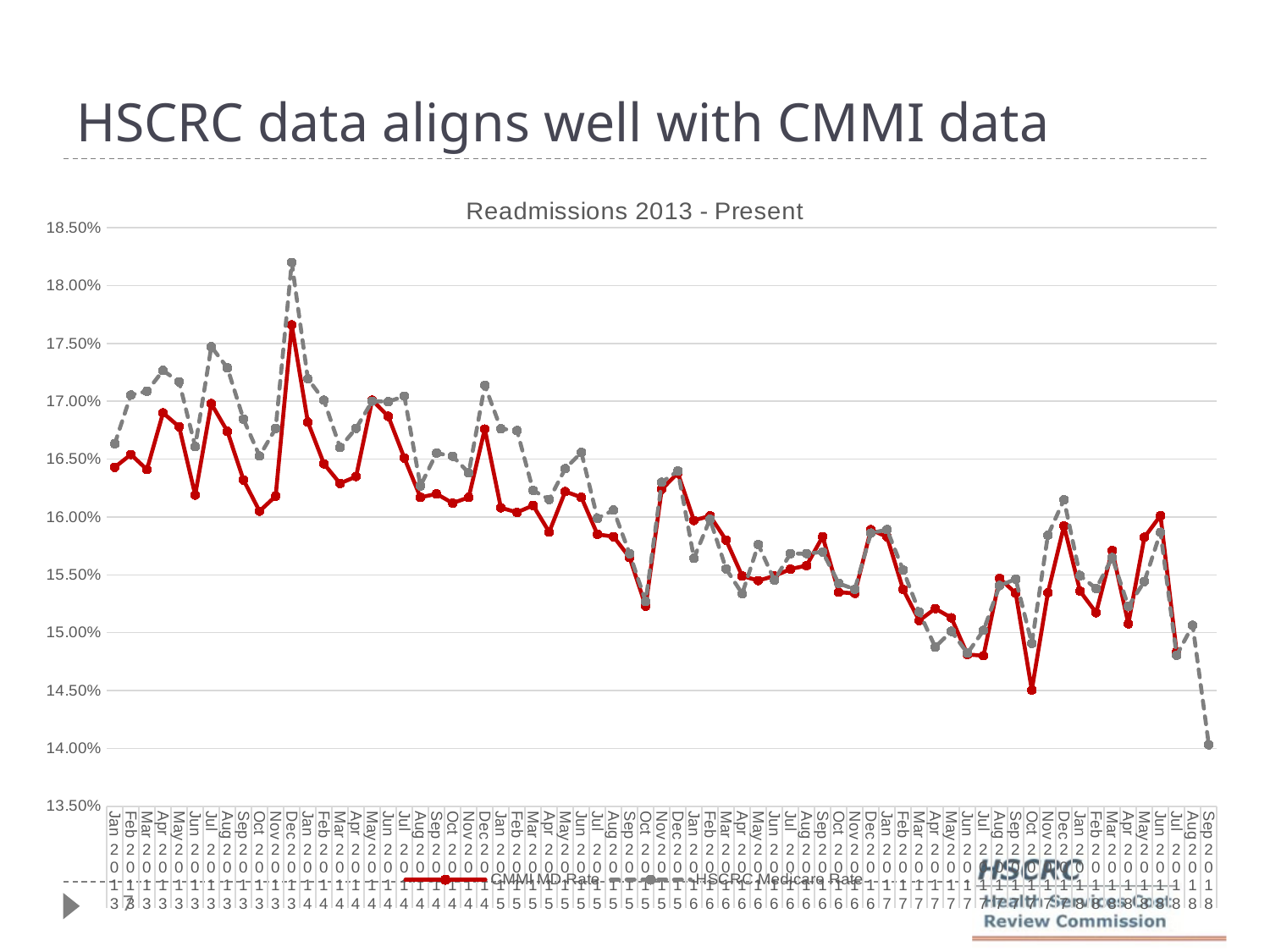
In which month is the HSCRC Medicare Rate at its highest? Dec 2013 How many series does the legend list? 2 Is the CMMI MD Rate for Jan 2013 greater or less than 17.00%? less In Dec 2013, which is larger: the CMMI MD Rate or the HSCRC Medicare Rate? HSCRC Medicare Rate Is the HSCRC Medicare Rate for Dec 2013 greater or less than 18.00%? greater Which series is drawn as a grey dashed line? HSCRC Medicare Rate Is the HSCRC Medicare Rate for Sep 2018 greater or less than 14.50%? less What is the title of the chart? Readmissions 2013 - Present Overall, do the readmission rates rise or fall from 2013 to 2018? fall In which month is the CMMI MD Rate at its highest? Dec 2013 In which month is the HSCRC Medicare Rate at its lowest? Sep 2018 What kind of chart is shown on the slide? line chart